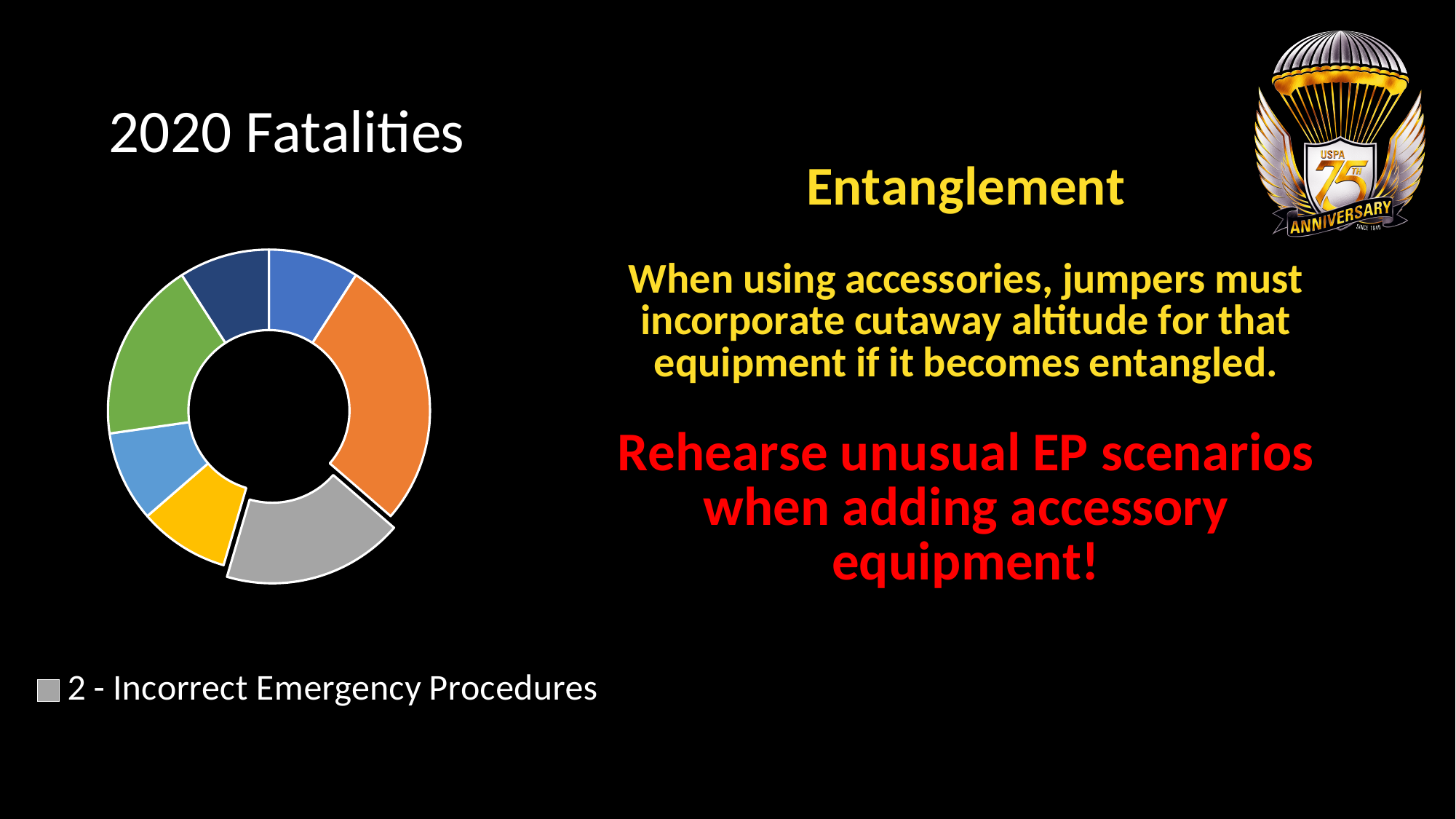
According to the legend, how many fatalities were attributed to Incorrect Emergency Procedures? 2 How many slices does the doughnut chart have? 7 Is the orange slice larger or smaller than the gray (Incorrect Emergency Procedures) slice? Larger What is the legend entry shown below the chart? 2 - Incorrect Emergency Procedures What kind of chart is shown on the slide? Doughnut (pie) chart Which colour slice is the largest in the doughnut chart? Orange Which colour slice represents Incorrect Emergency Procedures? Gray What is the title of the chart? 2020 Fatalities Is the green slice larger or smaller than the orange slice? Smaller How many entries does the chart legend list? 1